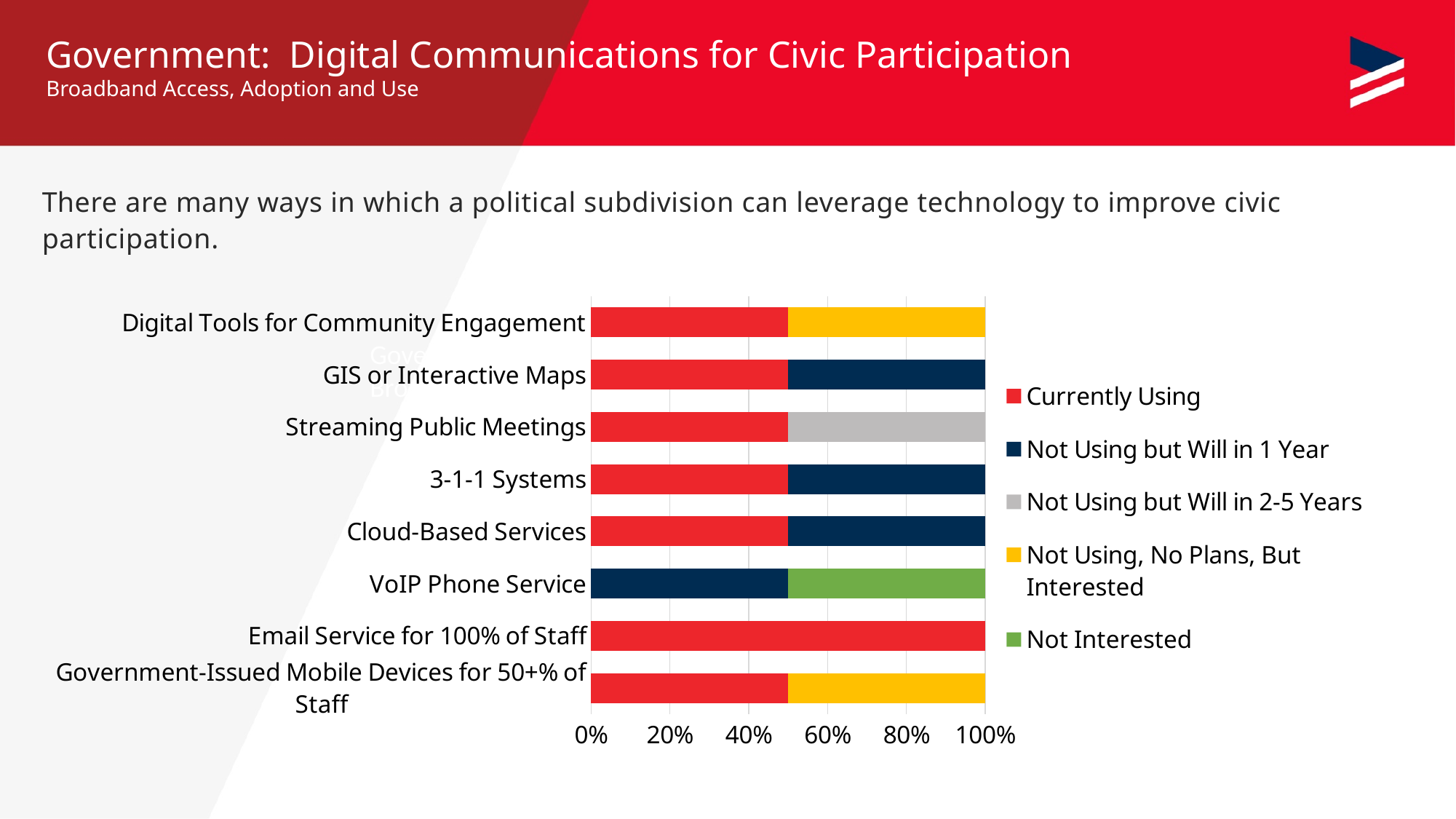
Which category is the only one with a 'Not Using but Will in 2-5 Years' segment? Streaming Public Meetings How many categories are plotted on the chart? 8 Which category has the lowest 'Currently Using' share? VoIP Phone Service What kind of chart is shown on the slide? Stacked bar chart Is the 'Not Interested' value for VoIP Phone Service greater or less than 40%? greater Which is larger: the 'Currently Using' value for Email Service for 100% of Staff or for Cloud-Based Services? Email Service for 100% of Staff Is the 'Currently Using' value for Streaming Public Meetings greater or less than 60%? less How many series does the legend list? 5 Which category is the only one with a 'Not Interested' segment? VoIP Phone Service What is the 'Currently Using' value for Email Service for 100% of Staff? 100% Is the 'Currently Using' value for GIS or Interactive Maps greater or less than 40%? greater Which category has the highest 'Currently Using' share? Email Service for 100% of Staff